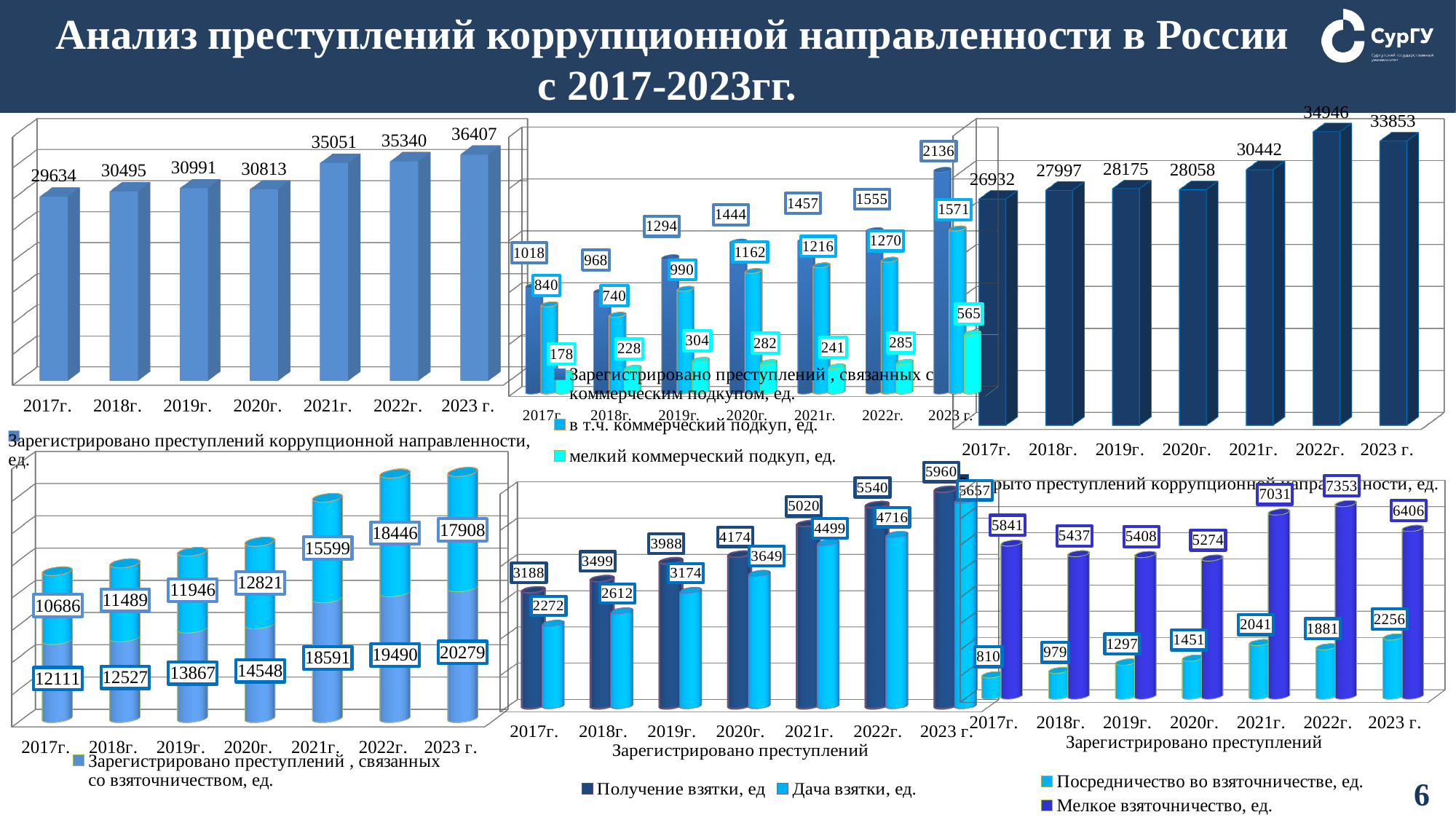
In the bottom-right chart, what is the value of 'Мелкое взяточничество, ед.' for 2022г.? 7353 In the bottom-middle chart, what is the value of 'Дача взятки, ед.' for 2021г.? 4499 In the top-left chart (Зарегистрировано преступлений коррупционной направленности), what is the value for 2023 г.? 36407 In the top-left chart (Зарегистрировано преступлений коррупционной направленности), which year has the lowest value? 2017г. In the top-middle chart on commercial bribery, what is the value of 'в т.ч. коммерческий подкуп, ед.' for 2019г.? 990 In the top-middle chart on commercial bribery, what is the value of 'мелкий коммерческий подкуп, ед.' for 2023 г.? 565 In the bottom-right chart, what is the difference between 'Мелкое взяточничество, ед.' and 'Посредничество во взяточничестве, ед.' for 2017г.? 5031 In the top-right chart (Раскрыто преступлений коррупционной направленности), what is the difference between the 2022г. and 2023 г. values? 1093 In the bottom-left stacked chart (Зарегистрировано преступлений, связанных со взяточничеством), what is the total of the stacked bar for 2017г.? 22797 In the top-right chart (Раскрыто преступлений коррупционной направленности), which year has the highest value? 2022г. In the bottom-middle chart, which is larger for 2023 г.: 'Получение взятки, ед' or 'Дача взятки, ед.'? Получение взятки, ед How many series does the legend of the top-middle chart on commercial bribery list? 3